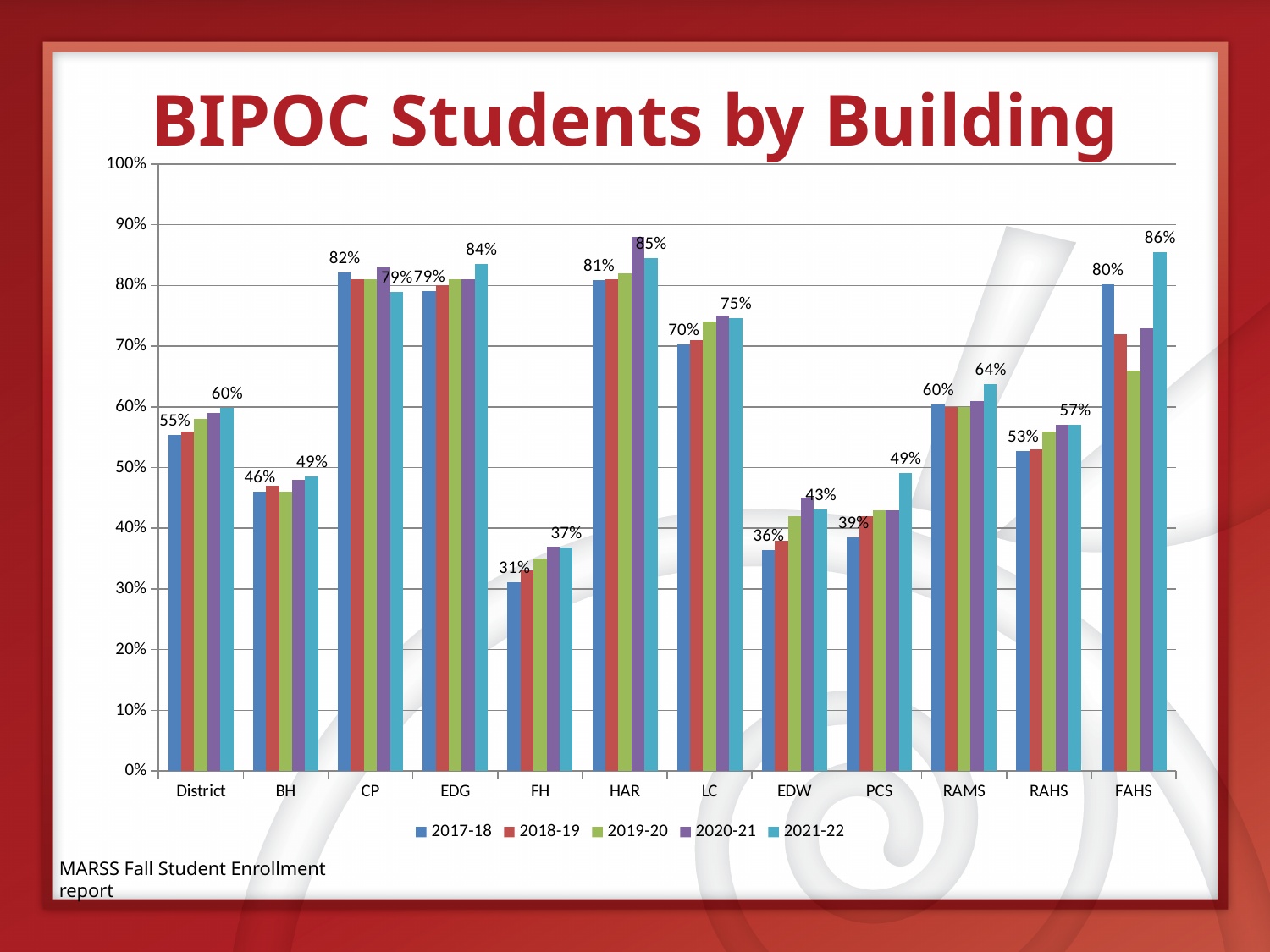
By how many percentage points did the PCS value change from 2017-18 to 2021-22? 10 percentage points What kind of chart is shown on the slide? bar chart What is the value for RAMS in 2021-22? 64% What is the value for FH in 2017-18? 31% How many series does the legend list? 5 Is the value for EDW in 2020-21 greater or less than 40%? greater What is the value for FAHS in 2021-22? 86% Which building has the highest value in 2017-18? CP Which is larger in 2017-18, CP or EDG? CP How many categories are shown on the x axis? 12 Does the value for FH rise or fall from 2017-18 to 2021-22? rise Which building has the lowest value in 2017-18? FH